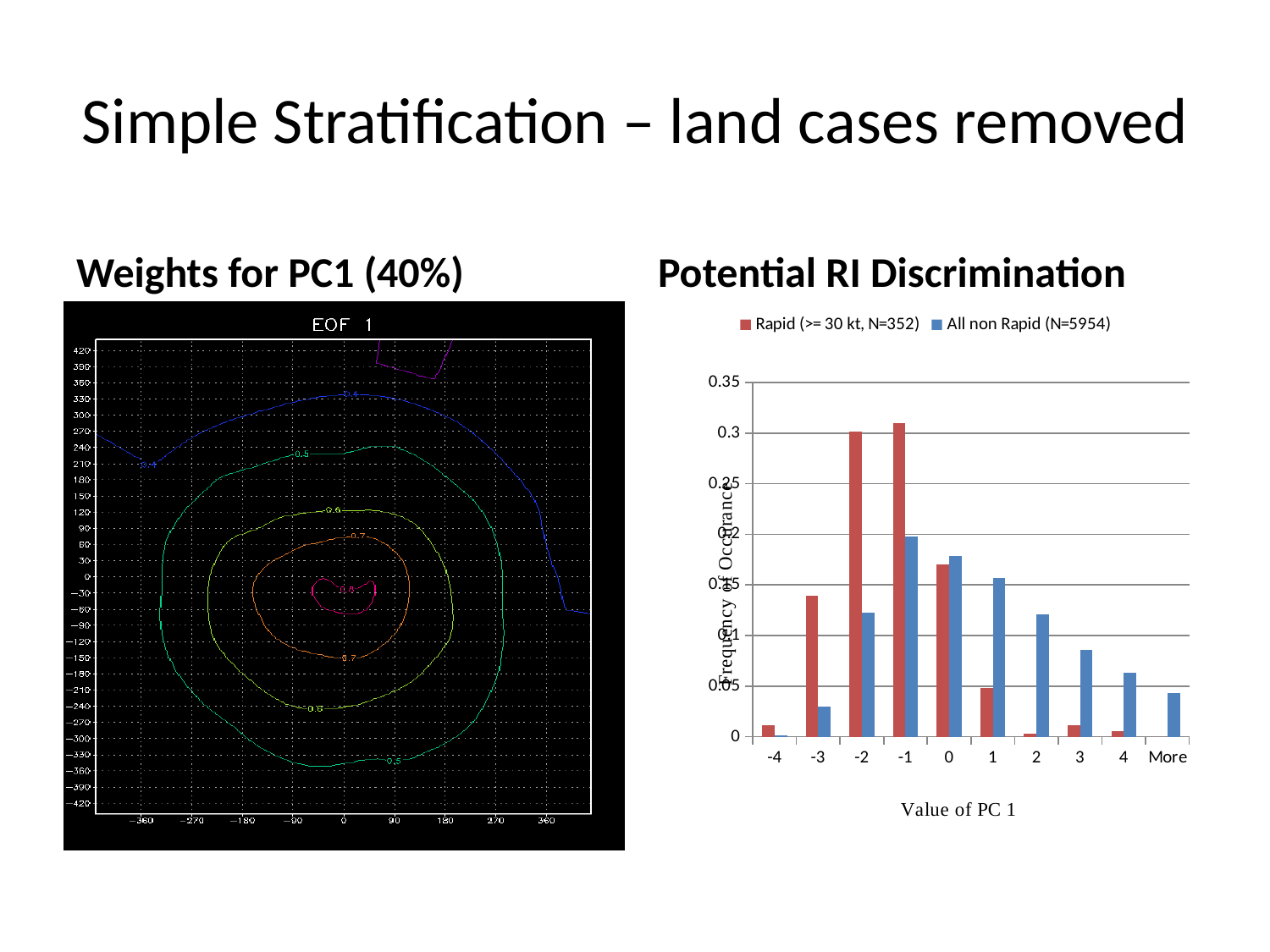
In the 'Potential RI Discrimination' chart, is the 'All non Rapid (N=5954)' value at 2 greater or less than 0.15? less In the 'Potential RI Discrimination' chart, is the 'Rapid (>= 30 kt, N=352)' value at -2 greater or less than 0.25? greater What kind of chart is the 'Potential RI Discrimination' chart on the right? bar chart How many categories are shown on the x axis of the 'Potential RI Discrimination' chart? 10 What is the x-axis title of the 'Potential RI Discrimination' chart? Value of PC 1 How many series does the legend of the 'Potential RI Discrimination' chart list? 2 In the 'Potential RI Discrimination' chart, at category -2, which series has the larger value? Rapid (>= 30 kt, N=352) In the 'Potential RI Discrimination' chart, which category has the lowest value for the 'All non Rapid (N=5954)' series? -4 In the 'Potential RI Discrimination' chart, at category 2, which series has the larger value? All non Rapid (N=5954) In the 'Potential RI Discrimination' chart, is the 'All non Rapid (N=5954)' value at 4 greater or less than 0.1? less In the 'Potential RI Discrimination' chart, which category has the highest value for the 'All non Rapid (N=5954)' series? -1